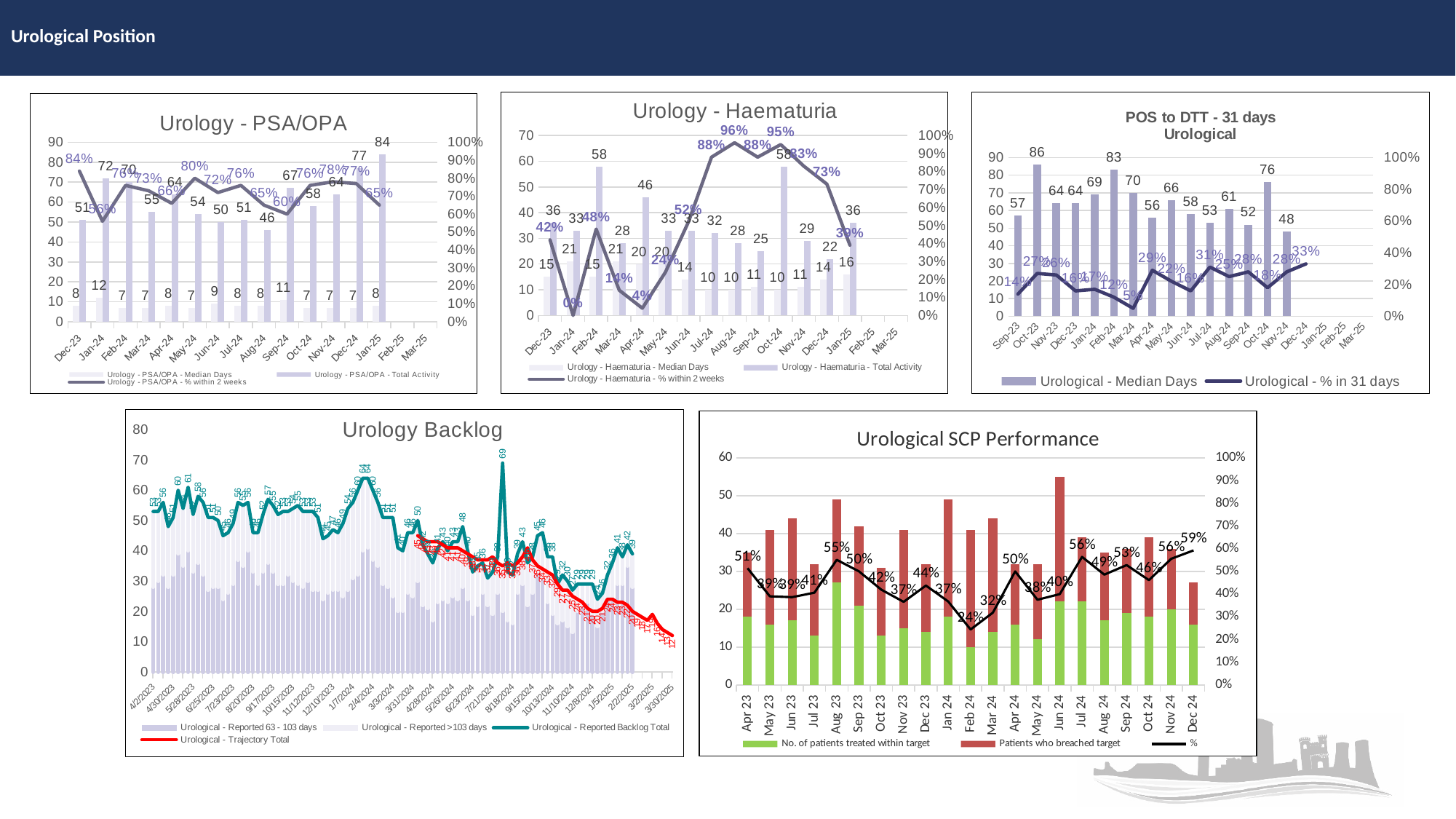
In the Urology - PSA/OPA chart, which month has the highest Total Activity? Jan-25 In the Urology - Haematuria chart, what is the Total Activity for Feb-24? 58 In the Urology - PSA/OPA chart, what is the % within 2 weeks for Dec-23? 84% In the Urological SCP Performance chart, what is the % value for Feb 24? 24% In the Urology - Haematuria chart, what is the % within 2 weeks for Aug-24? 96% In the POS to DTT - 31 days Urological chart, what is the % in 31 days for Mar-24? 5% In the Urology - PSA/OPA chart, what is the Total Activity value for Jan-25? 84 In the POS to DTT - 31 days Urological chart, which month has the highest Median Days? Oct-23 In the Urology - Haematuria chart, which month has the lowest % within 2 weeks? Jan-24 In the Urological SCP Performance chart, which is larger, the % for Jul 24 or the % for Oct 24? Jul 24 In the POS to DTT - 31 days Urological chart, how many series does the legend list? 2 In the Urology - PSA/OPA chart, what is the difference in Total Activity between Jan-25 and Dec-24? 7